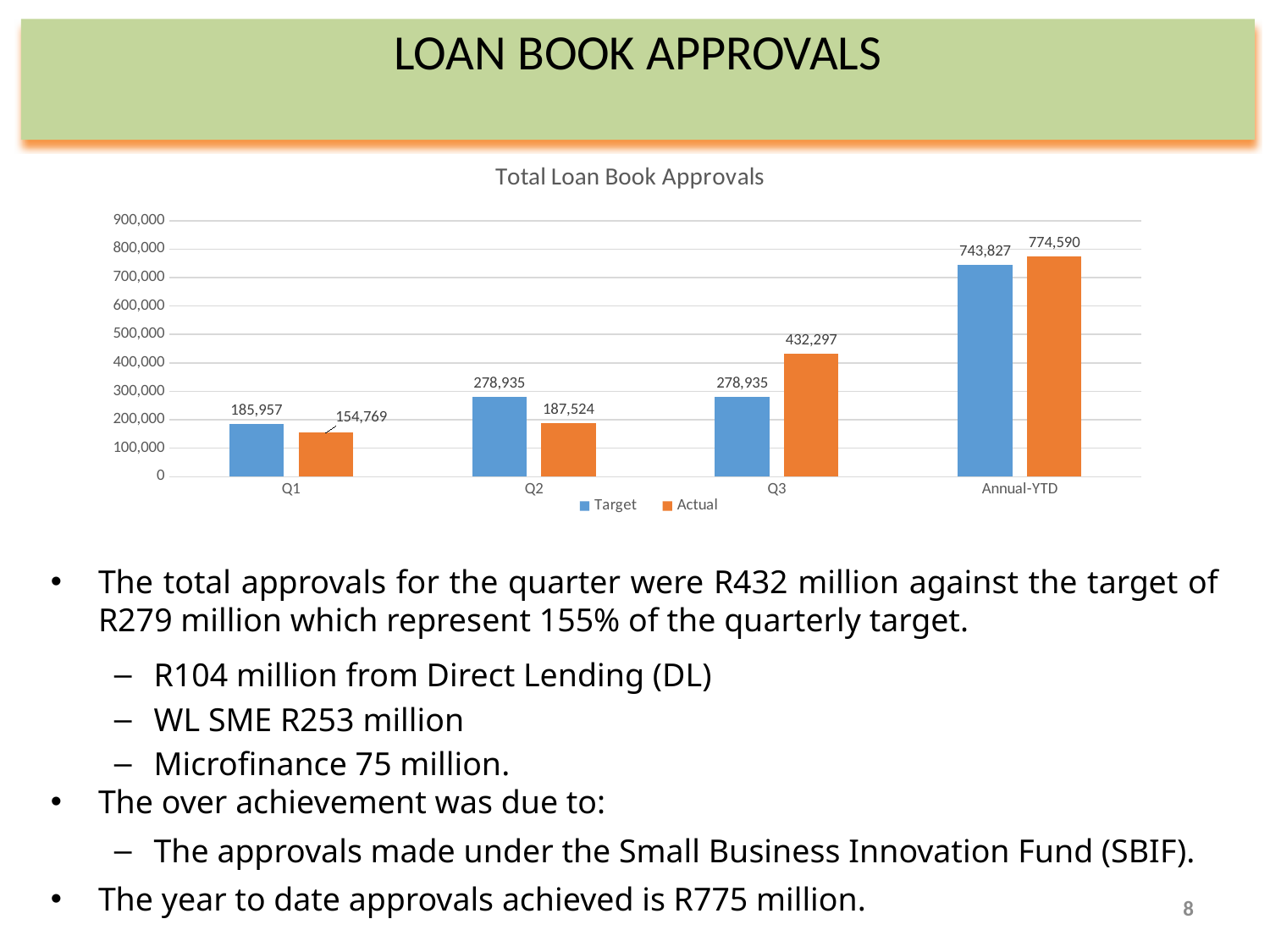
What is the Target value for Q2 in the Total Loan Book Approvals chart? 278,935 What is the Actual value for Q3 in the Total Loan Book Approvals chart? 432,297 What is the Actual value for Q1 in the Total Loan Book Approvals chart? 154,769 What is the Actual value for Annual-YTD in the Total Loan Book Approvals chart? 774,590 Which category has the highest Actual value in the Total Loan Book Approvals chart? Annual-YTD Which quarter has the lowest Actual value in the Total Loan Book Approvals chart? Q1 What type of chart is the Total Loan Book Approvals chart? Bar chart In the Total Loan Book Approvals chart, is the Target or the Actual value larger for Q2? Target Is the Target value for Annual-YTD greater or less than 700,000 in the Total Loan Book Approvals chart? greater What is the difference between the Actual and Target values for Q3 in the Total Loan Book Approvals chart? 153,362 How many series does the legend of the Total Loan Book Approvals chart list? 2 How many categories are shown on the x axis of the Total Loan Book Approvals chart? 4